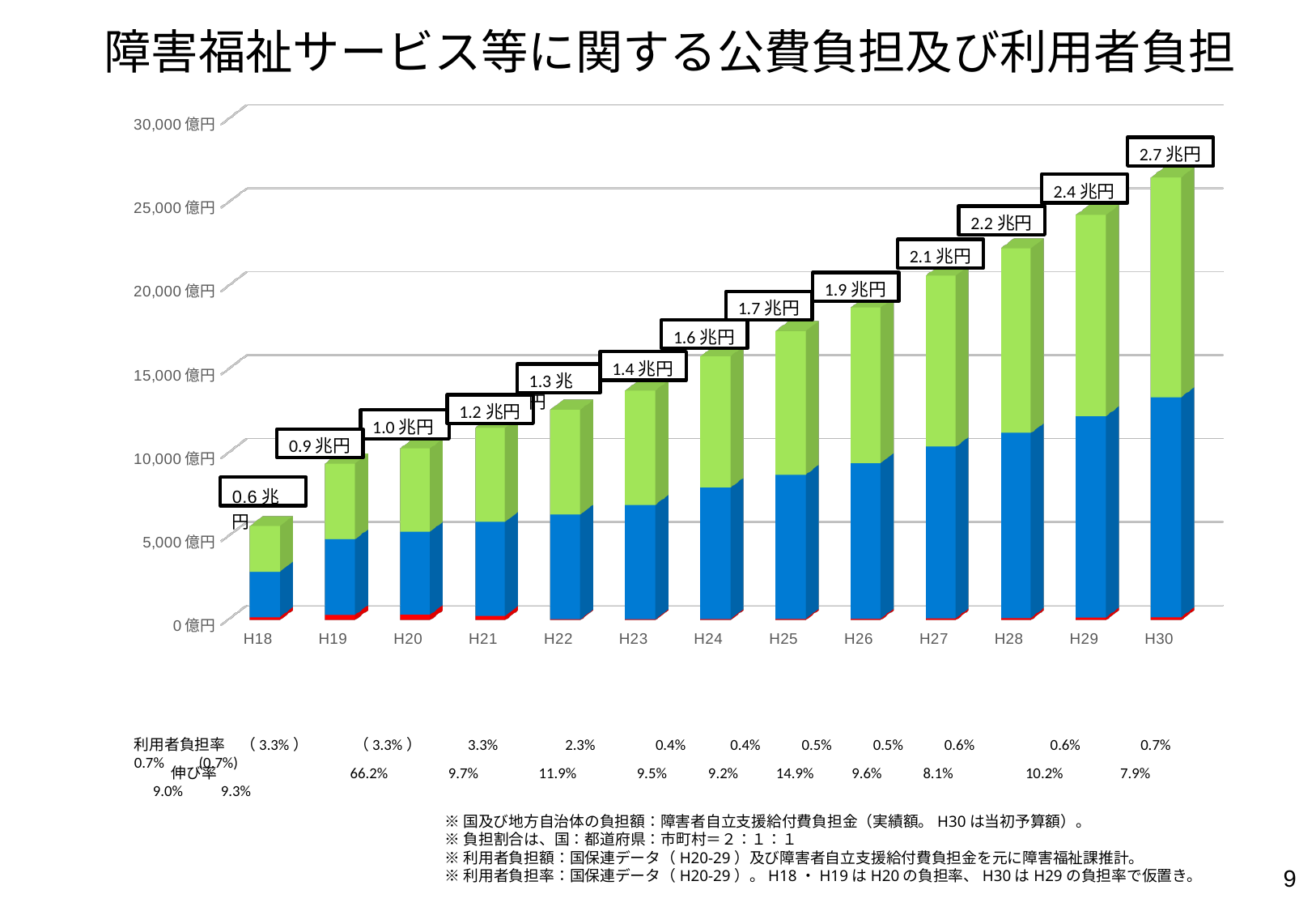
How many years are shown on the x axis? 13 Do the labelled totals rise or fall from H18 to H30? rise What total value is labelled above the bar for H22? 1.3 兆円 What total value is labelled above the bar for H30? 2.7 兆円 What total value is labelled above the bar for H18? 0.6 兆円 Which year has the highest labelled total? H30 What total value is labelled above the bar for H25? 1.7 兆円 Which year has the lowest labelled total? H18 What is the difference between the labelled totals for H30 and H18? 2.1 兆円 Is the total bar height for H30 greater or less than 25,000 億円? greater Which year has a larger labelled total, H24 or H27? H27 Is the total bar height for H18 greater or less than 10,000 億円? less